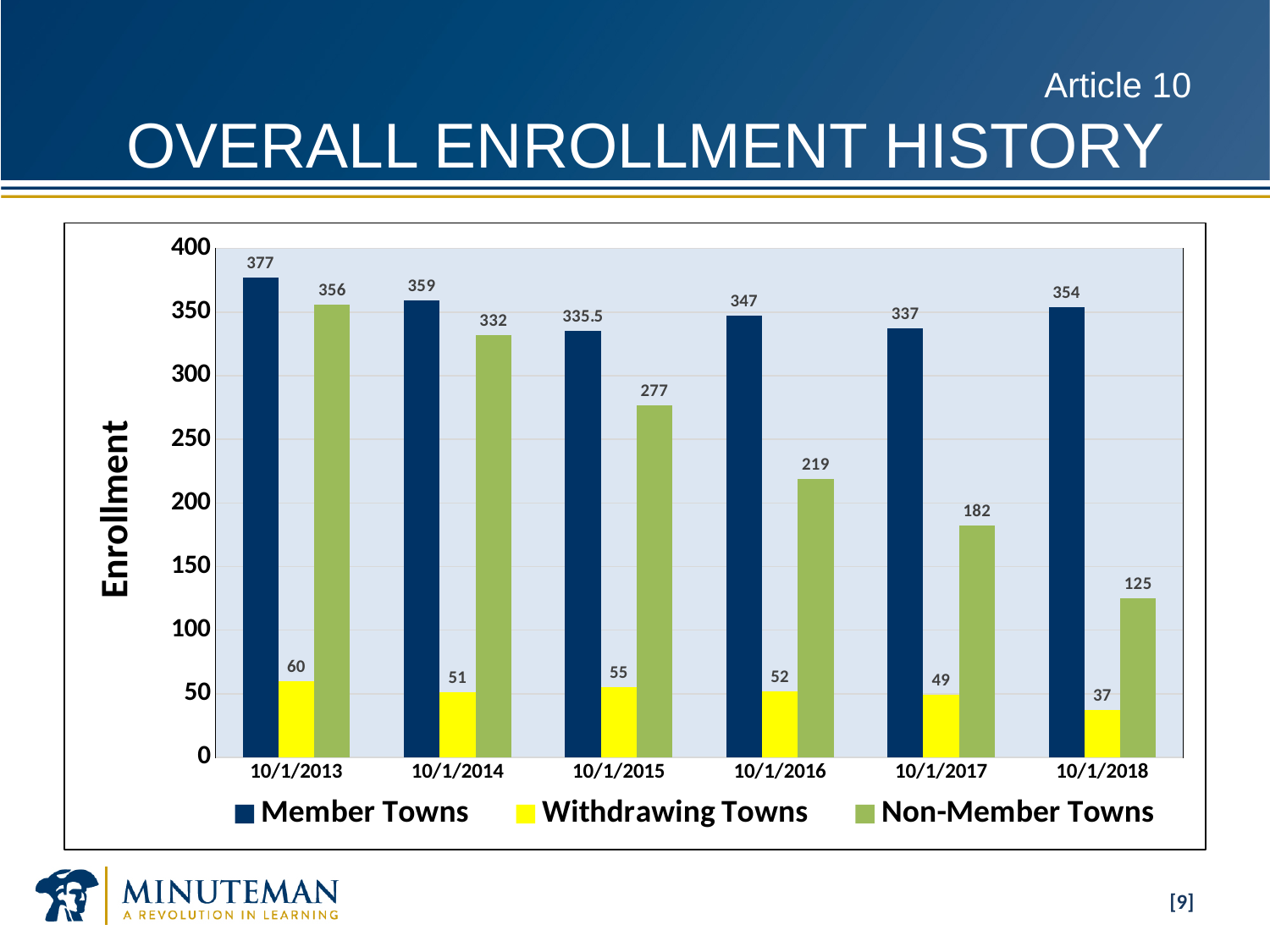
What was the Non-Member Towns enrollment on 10/1/2016? 219 What is the label on the y axis of the chart? Enrollment On which date was Member Towns enrollment highest? 10/1/2013 What kind of chart is shown on the slide? Bar chart How many series does the legend list? 3 What was the Member Towns enrollment on 10/1/2013? 377 What is the difference between Non-Member Towns enrollment on 10/1/2013 and on 10/1/2018? 231 Which was larger on 10/1/2014: Member Towns or Non-Member Towns enrollment? Member Towns What was the Withdrawing Towns enrollment on 10/1/2018? 37 Does Non-Member Towns enrollment rise or fall from 10/1/2013 to 10/1/2018? Fall On which date was Non-Member Towns enrollment lowest? 10/1/2018 How many dates are shown on the x axis? 6